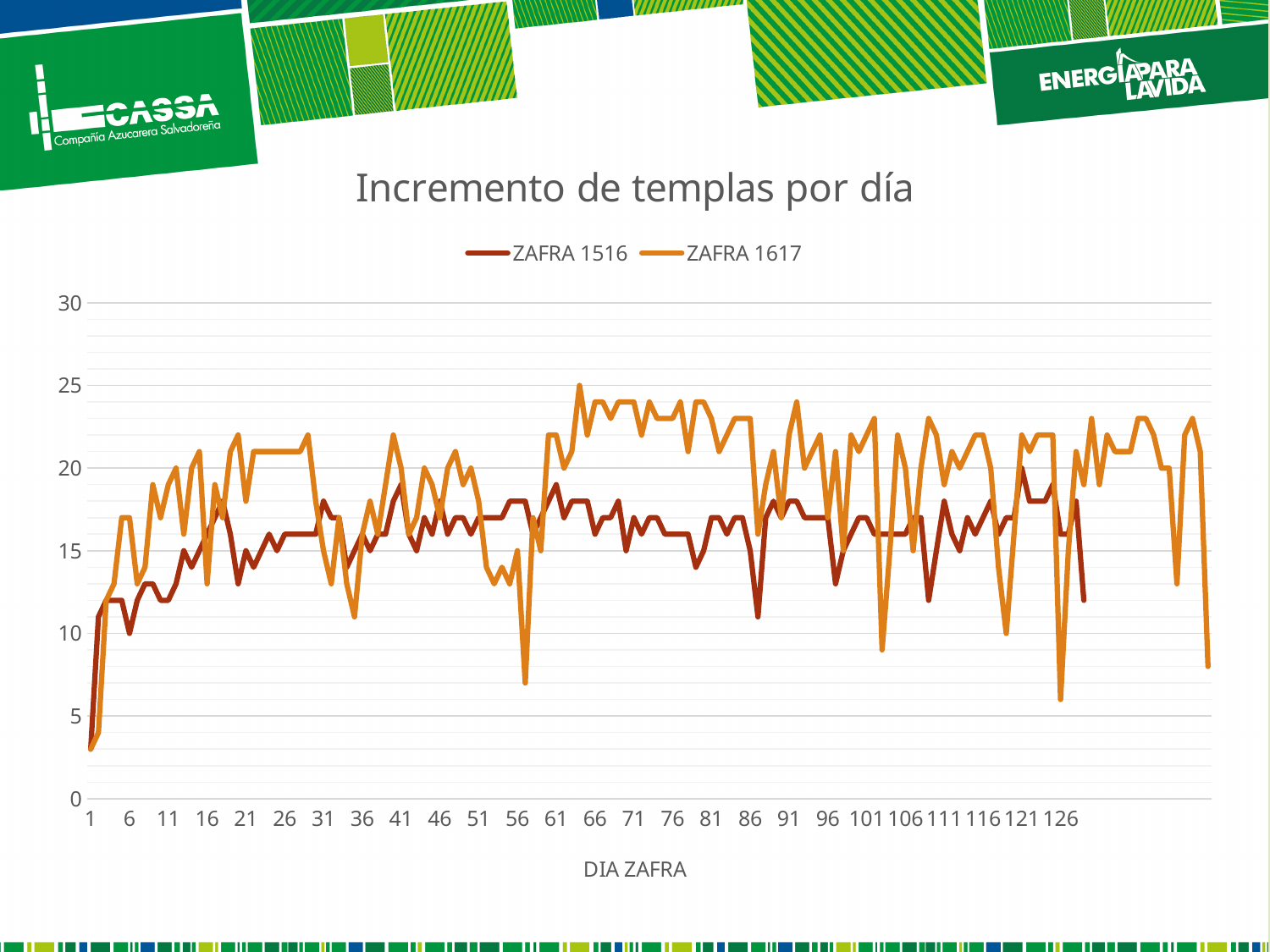
Is the value for ZAFRA 1617 at day 1 greater or less than 5? less How many series does the legend list? 2 What is the highest value shown on the y-axis? 30 Do the values for ZAFRA 1617 rise or fall between day 1 and day 6? rise Is the value for ZAFRA 1516 at day 41 greater or less than 15? greater What is the x-axis title of the chart? DIA ZAFRA What is the title of the chart? Incremento de templas por día Is the value for ZAFRA 1617 at day 126 greater or less than 10? less What kind of chart is shown on the slide? line chart Which series reaches the higher peak value, ZAFRA 1516 or ZAFRA 1617? ZAFRA 1617